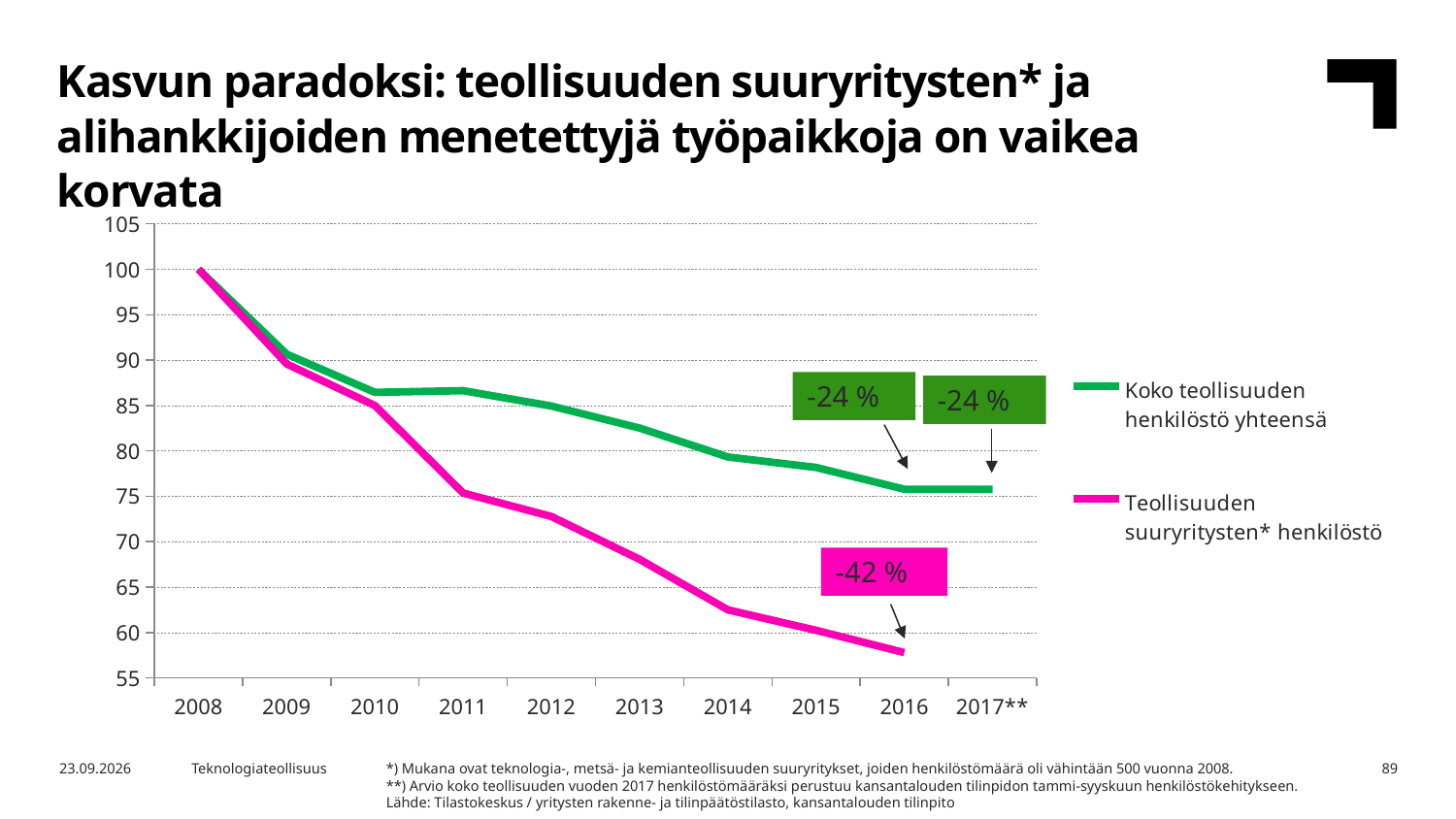
Is the value for Koko teollisuuden henkilöstö yhteensä in 2016 greater or less than 80? less How many years are shown on the x axis? 10 What percentage change is annotated for the Koko teollisuuden henkilöstö yhteensä series at 2017**? -24 % Is the value for Teollisuuden suuryritysten* henkilöstö in 2016 greater or less than 60? less What is the value of the Koko teollisuuden henkilöstö yhteensä series in 2008? 100 How many series does the legend list? 2 Which series has the higher value in 2016? Koko teollisuuden henkilöstö yhteensä What kind of chart is shown on the slide? line chart What percentage change is annotated for the Teollisuuden suuryritysten* henkilöstö series in 2016? -42 % Is the value for Teollisuuden suuryritysten* henkilöstö in 2012 greater or less than 70? greater Do the values of the Teollisuuden suuryritysten* henkilöstö series rise or fall from 2008 to 2016? fall In which year is the Teollisuuden suuryritysten* henkilöstö series at its lowest? 2016